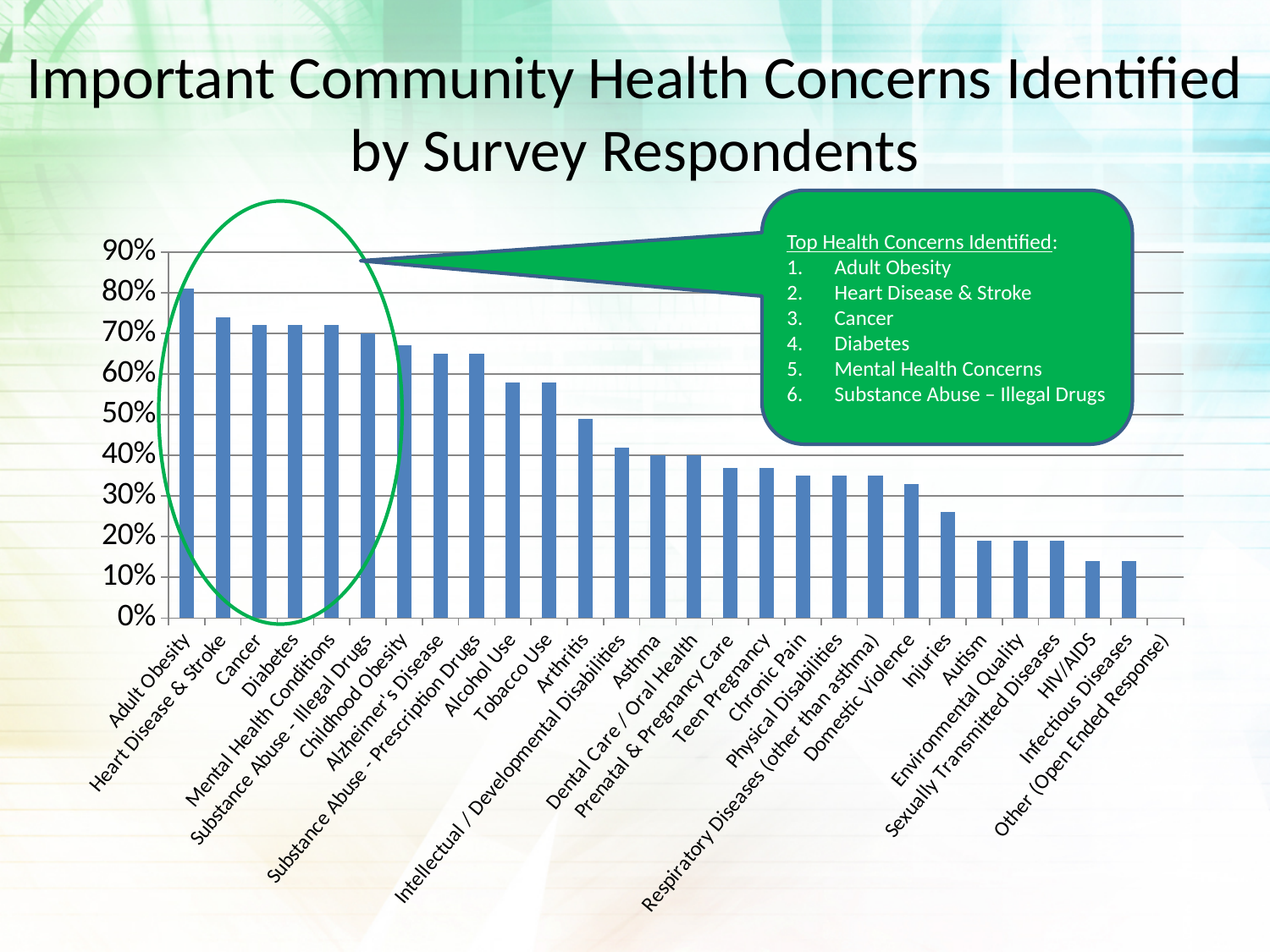
According to the callout on the slide, which health concern is listed as number 6 among the top health concerns identified? Substance Abuse – Illegal Drugs Is the value for Childhood Obesity greater or less than 60%? greater Is the value for Adult Obesity greater or less than 80%? greater Is the value for HIV/AIDS greater or less than 20%? less Which health concern has the highest value in the chart? Adult Obesity How many health concern categories are plotted in the chart? 28 What kind of chart is shown on the slide? bar chart Which is larger, the value for Heart Disease & Stroke or the value for Tobacco Use? Heart Disease & Stroke Which is larger, the value for Autism or the value for Domestic Violence? Domestic Violence Do the bar values rise or fall moving from left to right along the x axis? fall